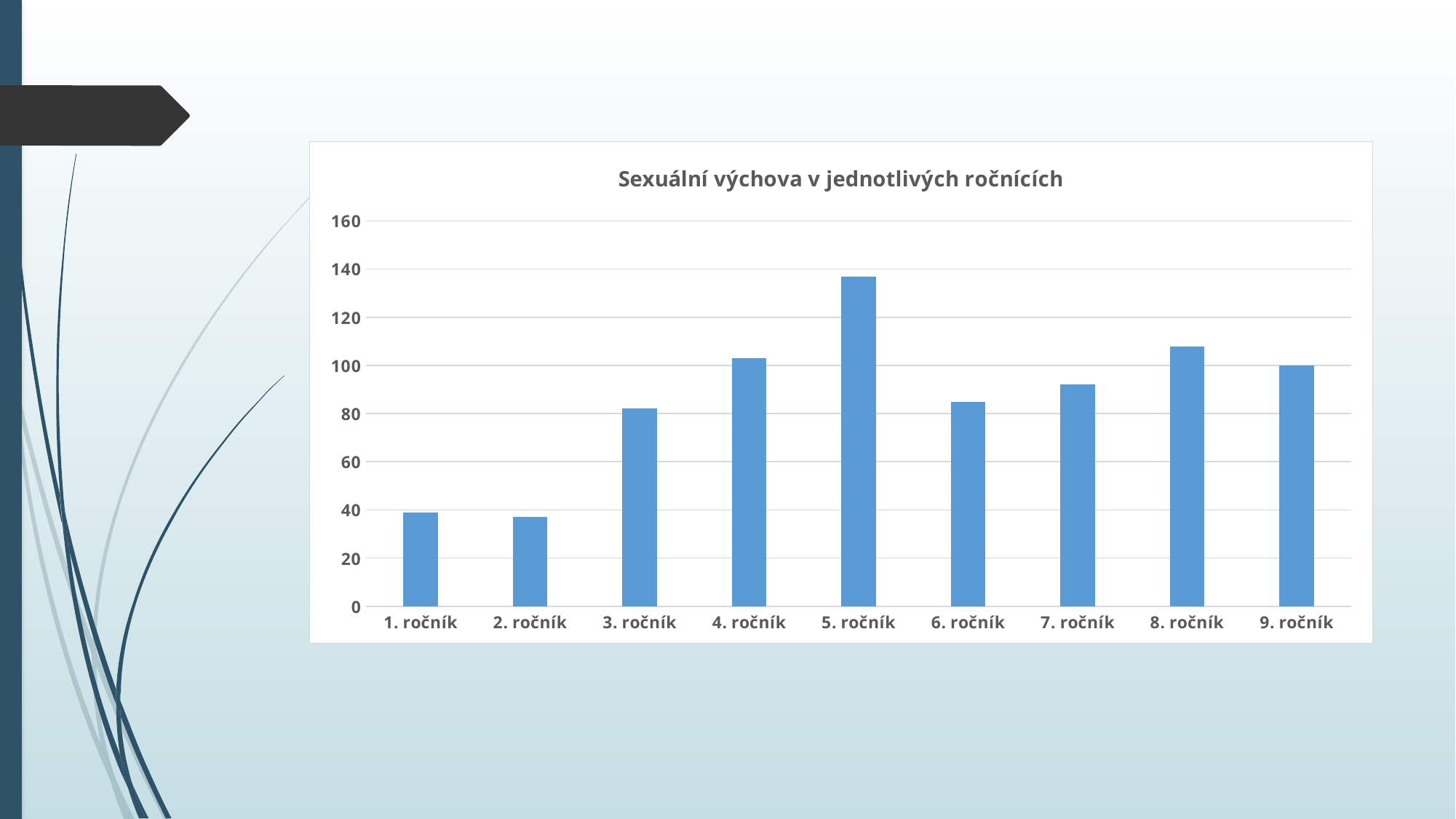
How many categories (ročníky) are shown on the x axis? 9 What kind of chart is shown on the slide? bar chart Is the value for 5. ročník greater or less than 120? greater What is the title of the chart? Sexuální výchova v jednotlivých ročnících Is the value for 4. ročník greater or less than 80? greater Is the value for 1. ročník greater or less than 60? less Which is larger, the value for 5. ročník or the value for 8. ročník? 5. ročník Which category has the highest value? 5. ročník Which is larger, the value for 1. ročník or the value for 3. ročník? 3. ročník